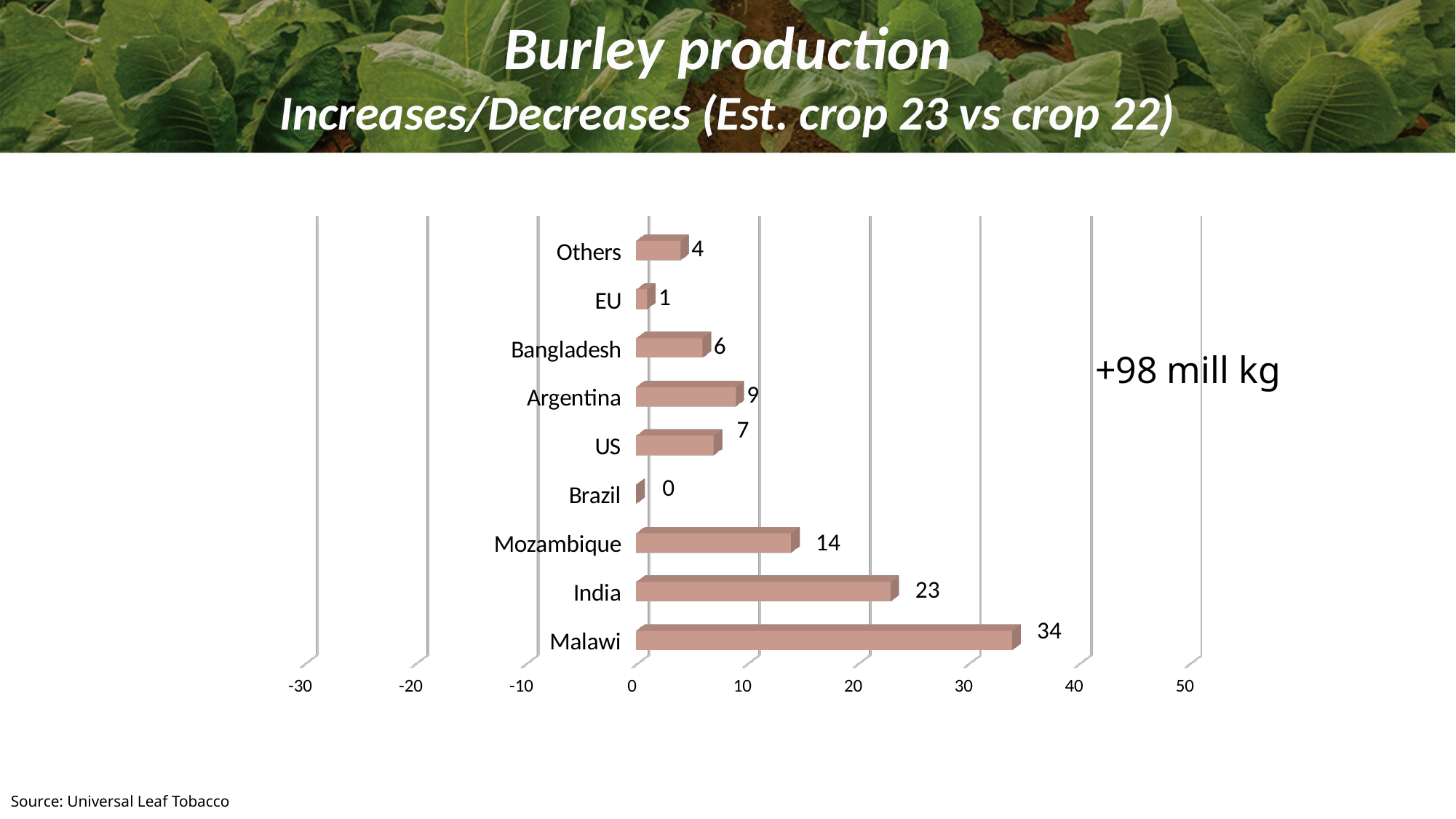
Which is larger, the value for Bangladesh or the value for US? US How many categories are shown in the chart? 9 What total figure is printed next to the chart? +98 mill kg Which category has the highest value? Malawi Is the value for Mozambique greater or less than 10? greater What is the difference between the values for Malawi and India? 11 What is the value for Argentina? 9 What is the value for Malawi? 34 Which category has the lowest value? Brazil What is the value for Mozambique? 14 What is the value for India? 23 What kind of chart is shown on the slide? Bar chart